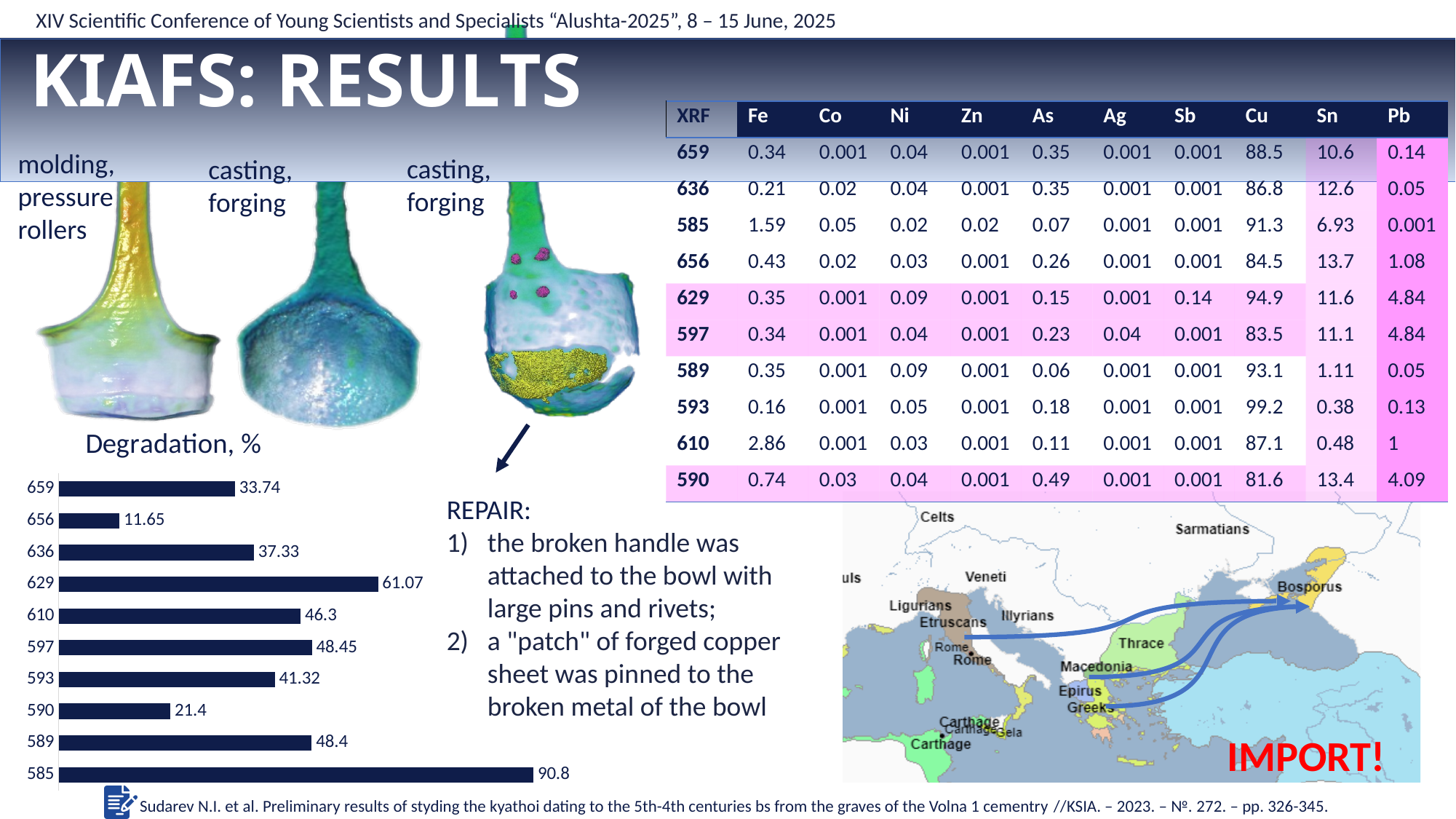
In the "Degradation, %" chart, which is larger, the value for 590 or the value for 659? 659 In the "Degradation, %" chart, what is the difference between the values for 585 and 629? 29.73 In the "Degradation, %" chart, which category has the lowest value? 656 What is the title of the bar chart on the slide? Degradation, % In the "Degradation, %" chart, which category has the highest value? 585 In the "Degradation, %" chart, what is the value for 590? 21.4 What type of chart is the "Degradation, %" chart? bar chart In the "Degradation, %" chart, what is the difference between the values for 636 and 656? 25.68 How many categories are shown in the "Degradation, %" chart? 10 In the "Degradation, %" chart, what is the value for 629? 61.07 In the "Degradation, %" chart, which is larger, the value for 610 or the value for 593? 610 In the "Degradation, %" chart, what is the value for 659? 33.74